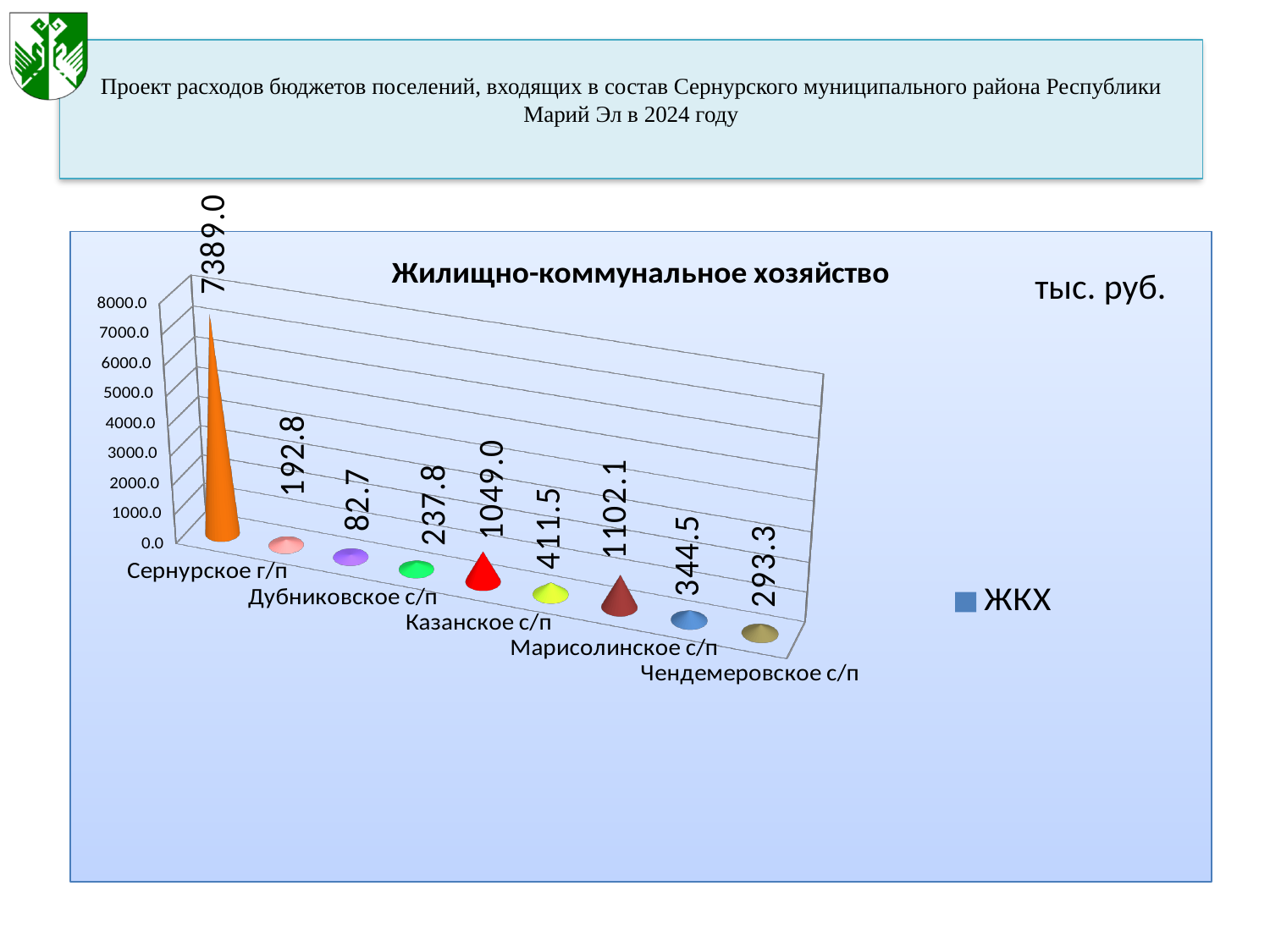
What is the value for Казанское с/п? 1049.0 Which category has the highest value? Сернурское г/п What is the title of the chart? Жилищно-коммунальное хозяйство How many data points are plotted in the chart? 9 What is the value for Марисолинское с/п? 1102.1 What is the difference between the values for Марисолинское с/п and Казанское с/п? 53.1 What is the value for Сернурское г/п? 7389.0 How many series does the legend list? 1 What is the value for Дубниковское с/п? 82.7 Which is larger, the value for Чендемеровское с/п or the value for Казанское с/п? Казанское с/п Which labelled category has the lowest value? Дубниковское с/п What is the value for Чендемеровское с/п? 293.3